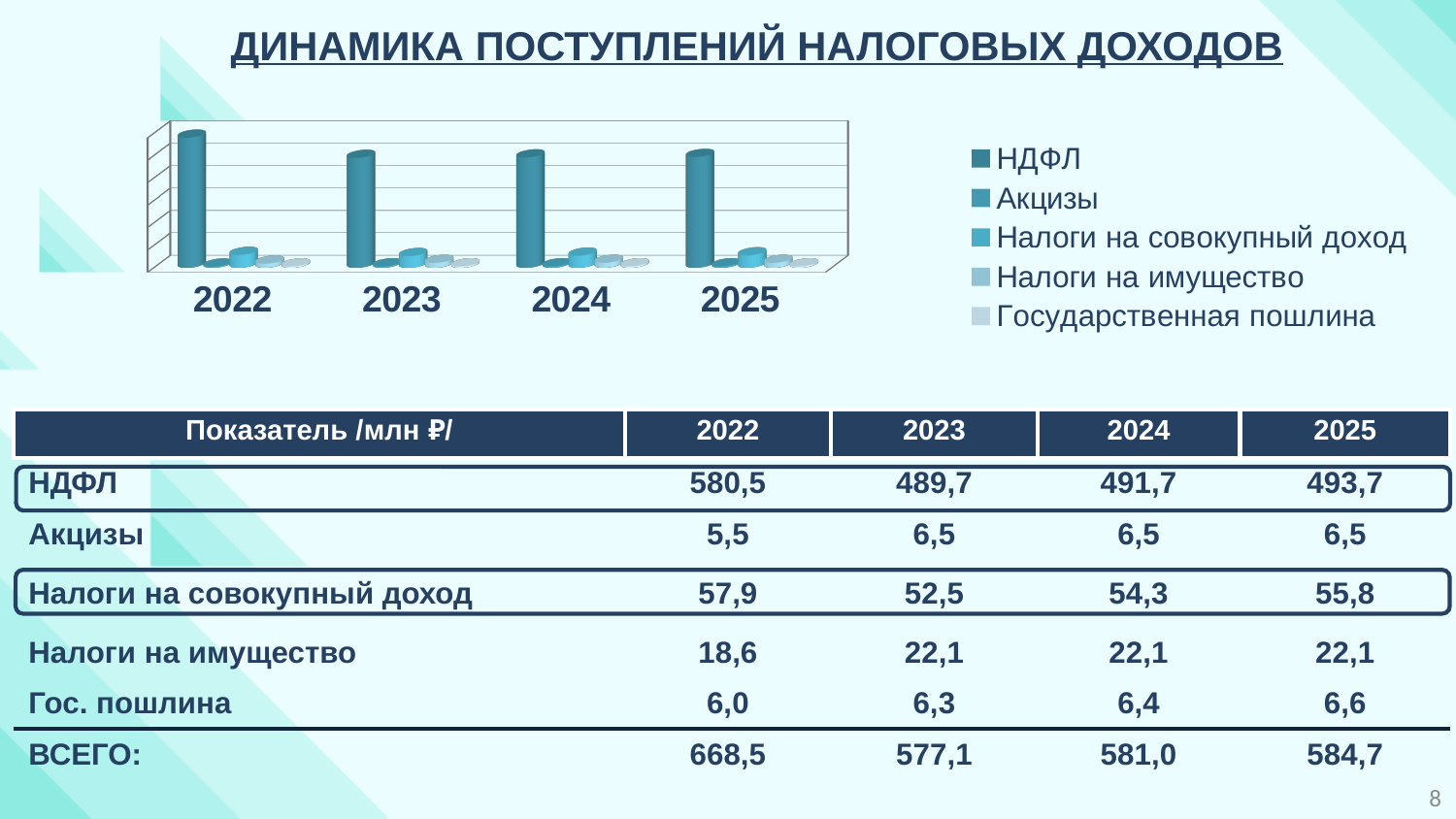
According to the slide, what is the value of Налоги на имущество for 2023 (млн ₽)? 22,1 What kind of chart is shown on the slide? bar chart Which series is listed first in the chart legend? НДФЛ What is the difference between the НДФЛ values for 2022 and 2023 (млн ₽)? 90,8 How many years are shown along the x axis of the chart? 4 Which year has the tallest НДФЛ bar in the chart? 2022 According to the slide, what is the value of НДФЛ for 2022 (млн ₽)? 580,5 According to the slide, what is the value of Налоги на совокупный доход for 2025 (млн ₽)? 55,8 Does the Гос. пошлина value rise or fall from 2022 to 2025? rise What is the total (ВСЕГО) of all tax revenues for 2025 (млн ₽)? 584,7 Is the НДФЛ bar for 2022 taller or shorter than the НДФЛ bar for 2023? taller How many series does the chart legend list? 5